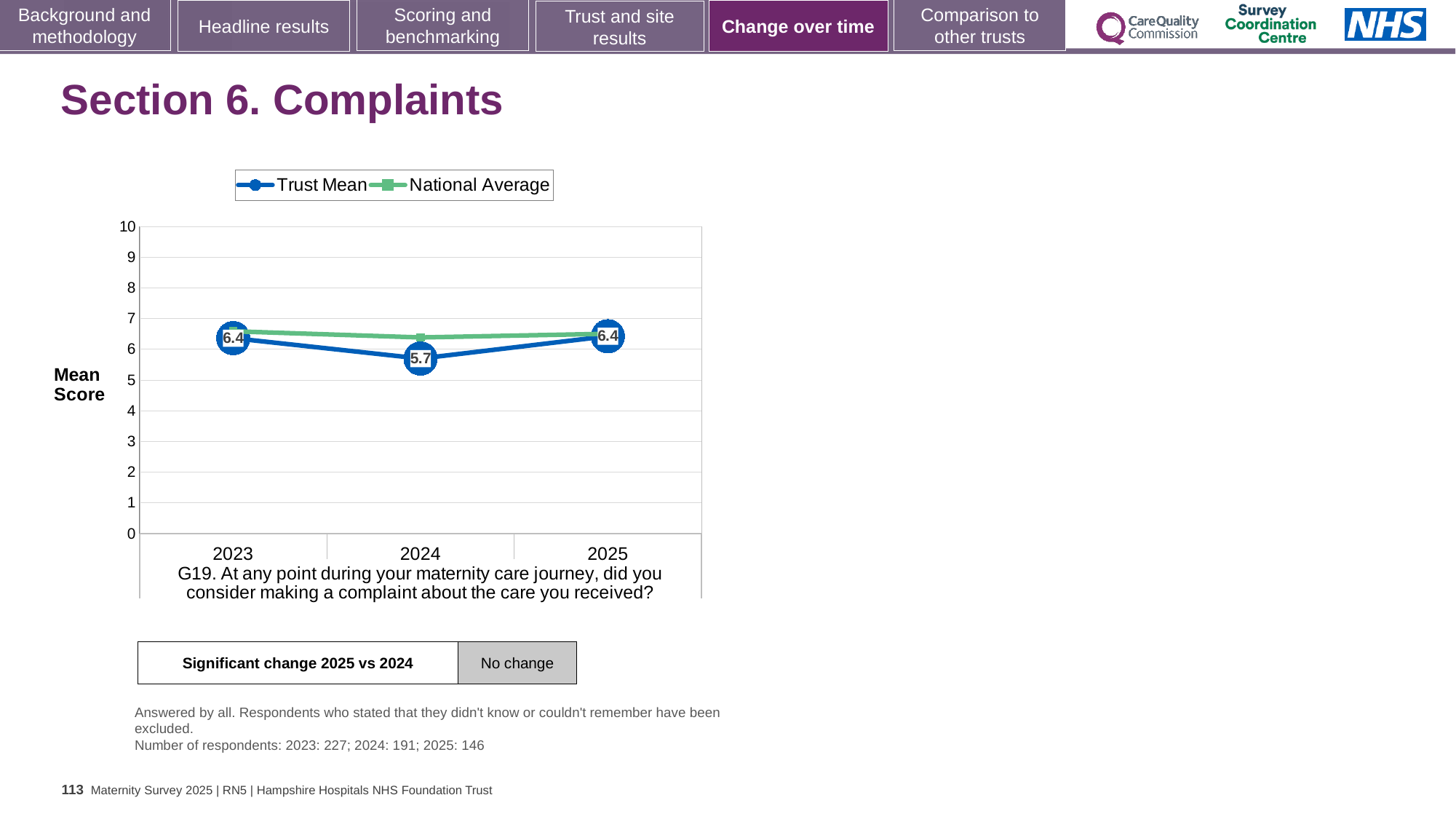
What are the two series named in the chart legend? Trust Mean and National Average What is the Trust Mean score for 2025? 6.4 How many years are plotted on the x axis of the chart? 3 What kind of chart is shown on the slide? Line chart What is the Trust Mean score for 2023? 6.4 Is the National Average value for 2024 greater or less than 5? greater What is the difference between the Trust Mean score in 2023 and in 2024? 0.7 What is the Trust Mean score for 2024? 5.7 Which is larger, the Trust Mean score for 2024 or for 2025? 2025 In which year is the Trust Mean score lowest? 2024 Is the National Average value for 2023 greater or less than 8? less How many series does the chart legend list? 2